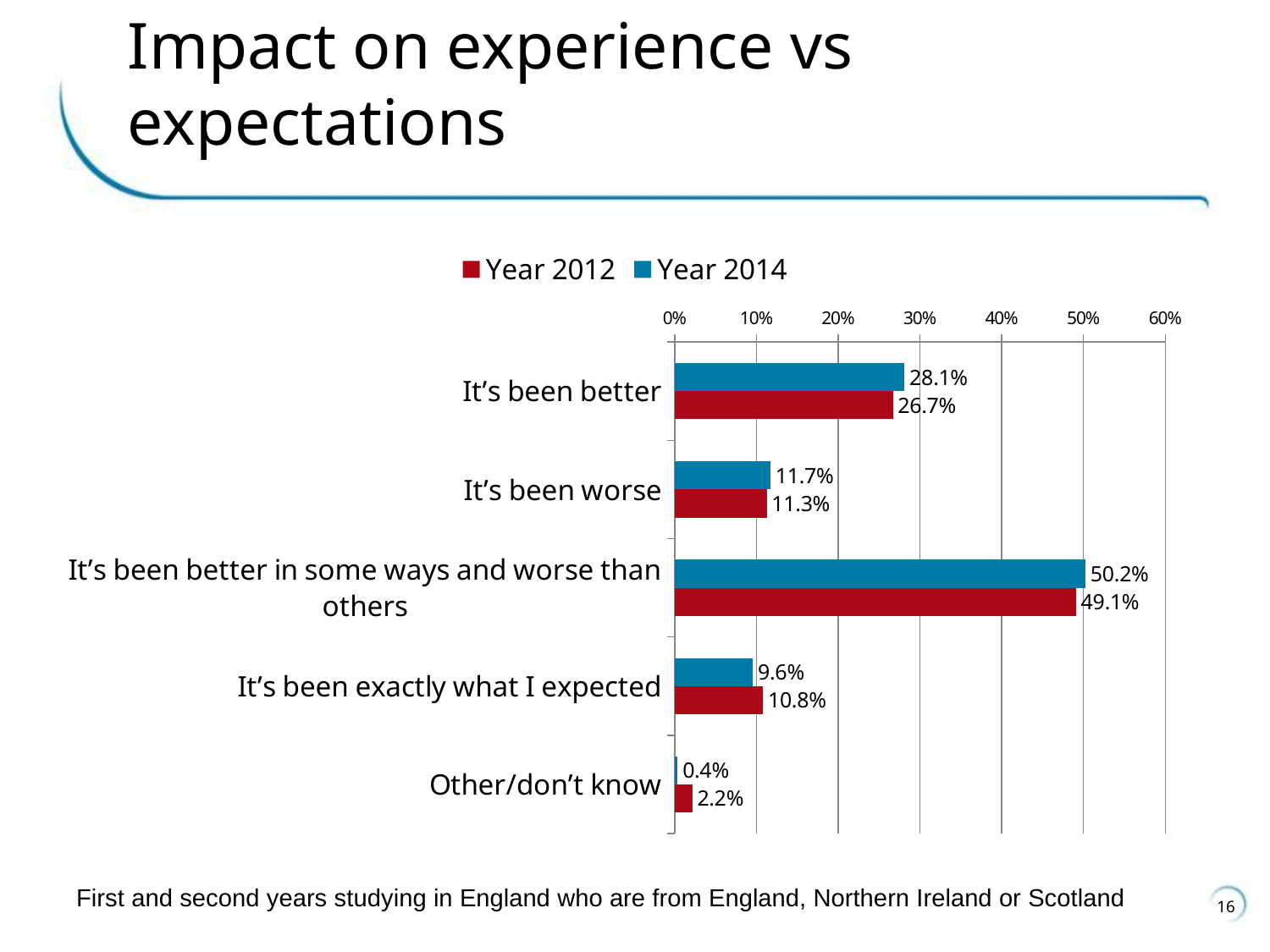
What kind of chart is shown on the slide? Bar chart What is the difference between the Year 2014 and Year 2012 values for "It's been better in some ways and worse than others"? 1.1% For "It's been exactly what I expected", which year has the larger value, Year 2012 or Year 2014? Year 2012 Which category has the highest Year 2014 value? It's been better in some ways and worse than others How many series does the legend list? 2 Is the Year 2012 value for "It's been worse" greater or less than 20%? less What is the Year 2012 value for "It's been exactly what I expected"? 10.8% How many categories are shown on the chart? 5 What is the Year 2014 value for "It's been better"? 28.1% What is the Year 2012 value for "Other/don't know"? 2.2% Which colour represents Year 2014 in the chart? Blue Which category has the lowest Year 2012 value? Other/don't know